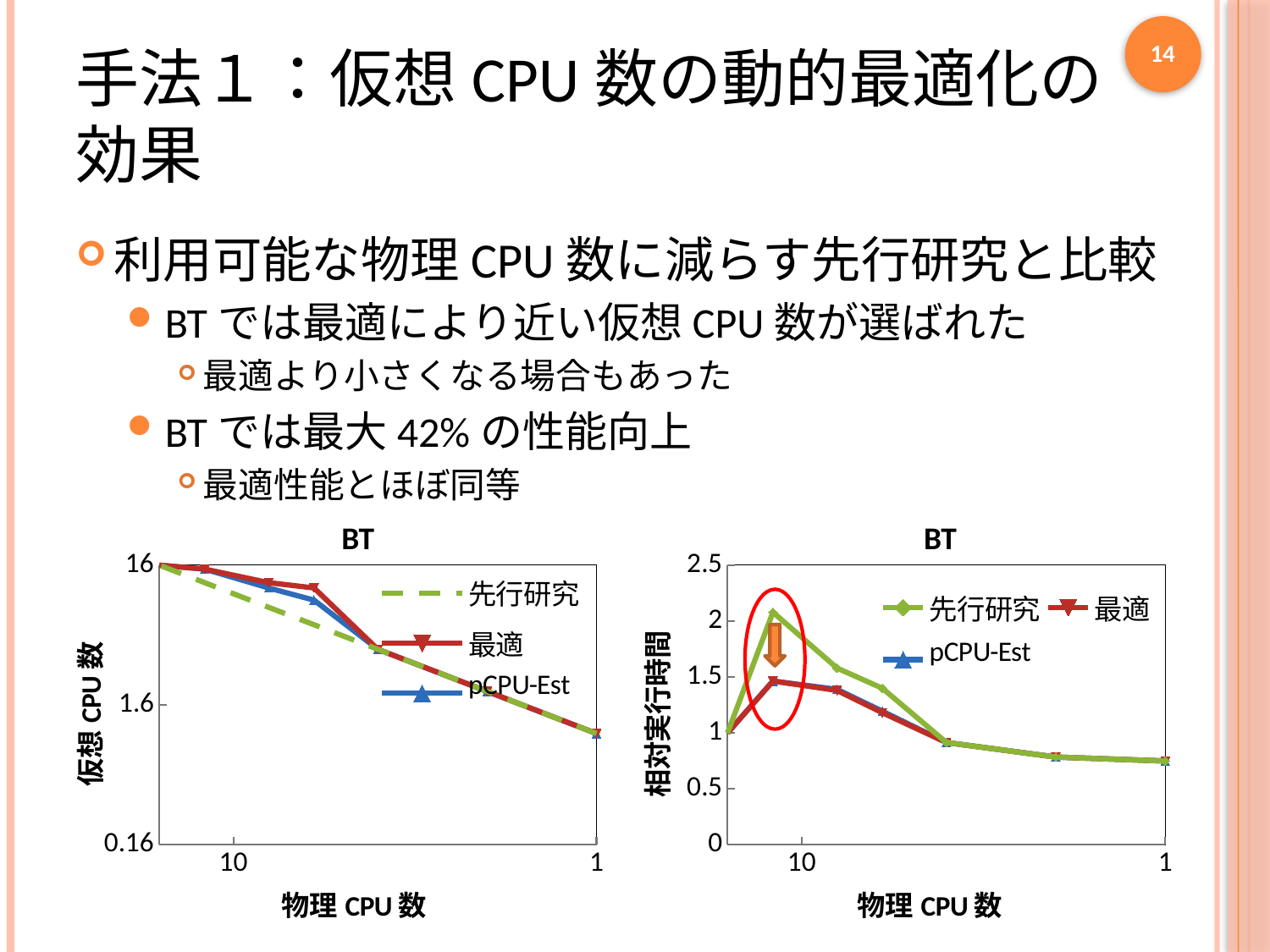
How many series does the legend of the left chart list? 3 What is the y-axis label of the left chart? 仮想 CPU 数 How many series does the legend of the right chart list? 3 In the right chart, is the peak value of 先行研究 greater or less than 1.5? greater What kind of chart is the left chart titled BT? line chart What kind of chart is the right chart titled BT? line chart In the right chart, which series reaches the highest value? 先行研究 What is the y-axis label of the right chart? 相対実行時間 In the right chart, is the value of 先行研究 at 物理 CPU 数 = 1 greater or less than 1? less In the left chart, is the value of 最適 at 物理 CPU 数 = 1 greater or less than 1.6? less In the left chart, do the values of 先行研究 rise or fall from left to right along the x axis? fall